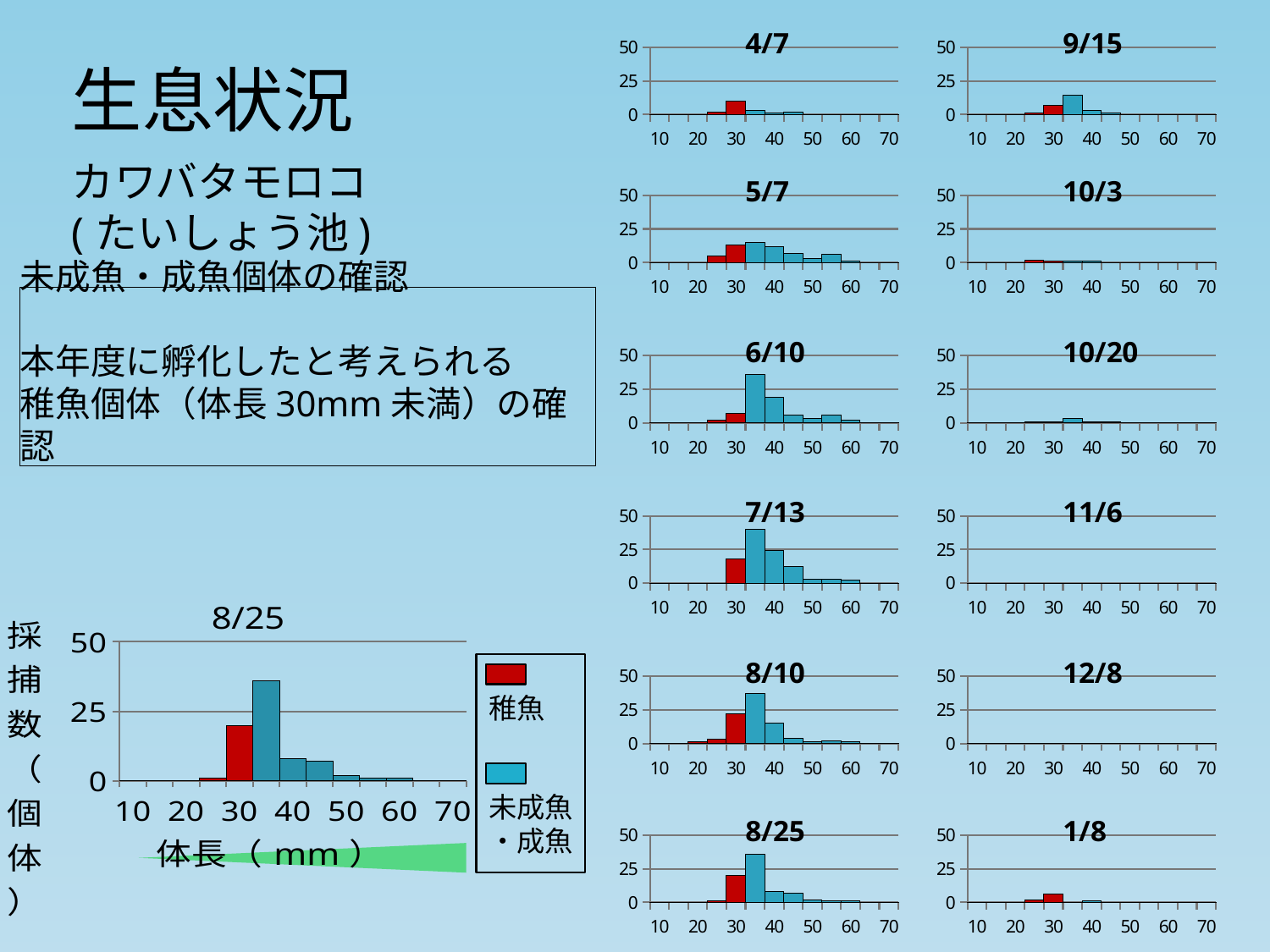
In the 1/8 chart, is the value of the tallest bar greater or less than 25? less In the 7/13 chart, is the value of the tallest bar greater or less than 25? greater In the 4/7 chart, is the value of the tallest bar greater or less than 25? less How many series does the legend next to the large 8/25 chart list? 2 In the legend next to the large 8/25 chart, which colour represents 稚魚? red What kind of chart is the large 8/25 chart at the bottom left of the slide? bar chart In the large 8/25 chart, which is taller: the tallest red (稚魚) bar or the tallest blue (未成魚・成魚) bar? the tallest blue (未成魚・成魚) bar In the legend next to the large 8/25 chart, which colour represents 未成魚・成魚? blue